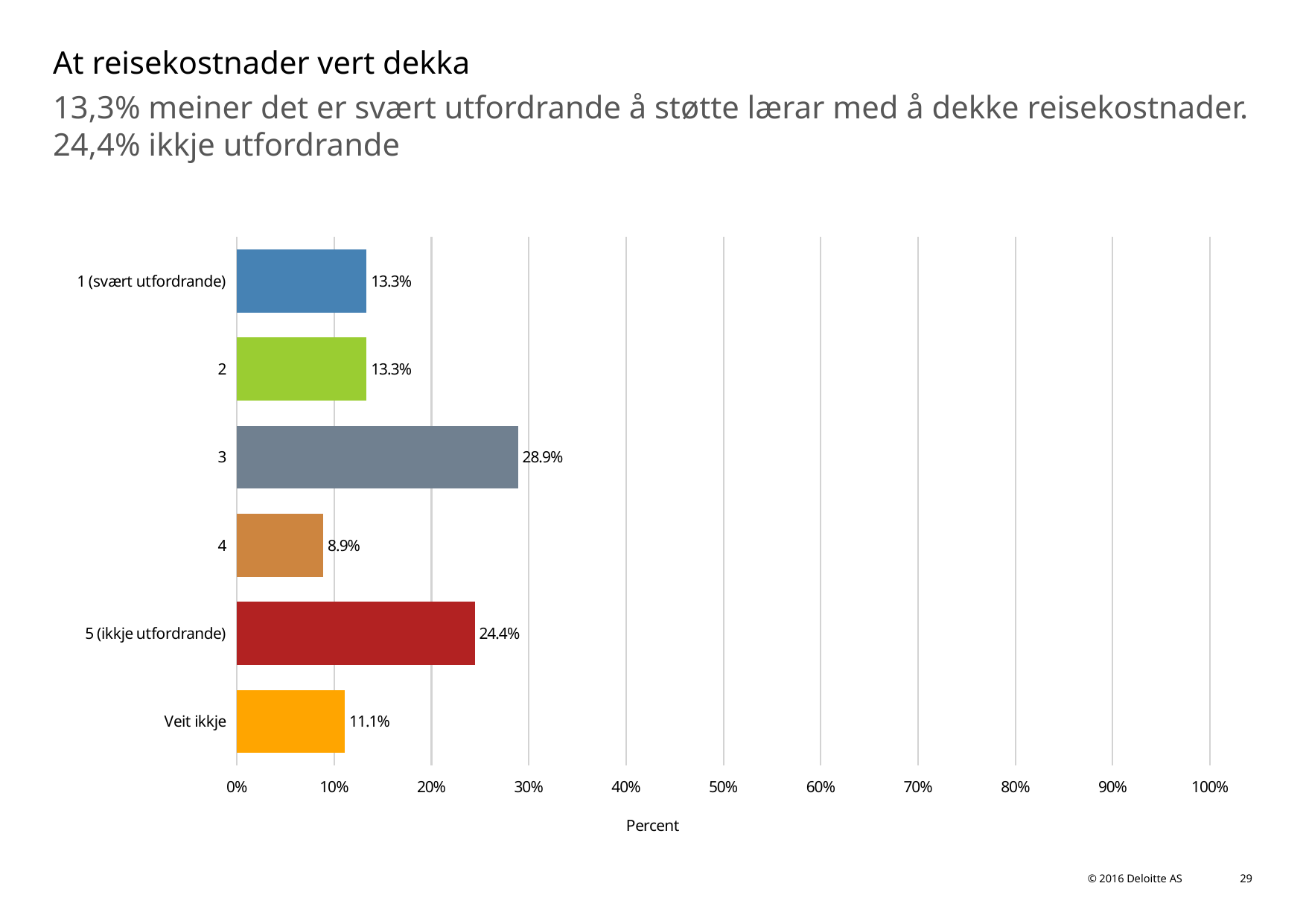
What kind of chart is shown on the slide? bar chart What is the label of the horizontal axis? Percent Is the value for "5 (ikkje utfordrande)" greater or less than 20%? greater What is the difference between the values for "3" and "5 (ikkje utfordrande)"? 4.5% Which category has the lowest value? 4 Which category has the highest value? 3 What is the value for "1 (svært utfordrande)"? 13.3% What is the value for "3"? 28.9% How many categories are shown in the chart? 6 What is the value for "Veit ikkje"? 11.1% What is the value for "5 (ikkje utfordrande)"? 24.4% Which is larger, the value for "4" or the value for "Veit ikkje"? Veit ikkje